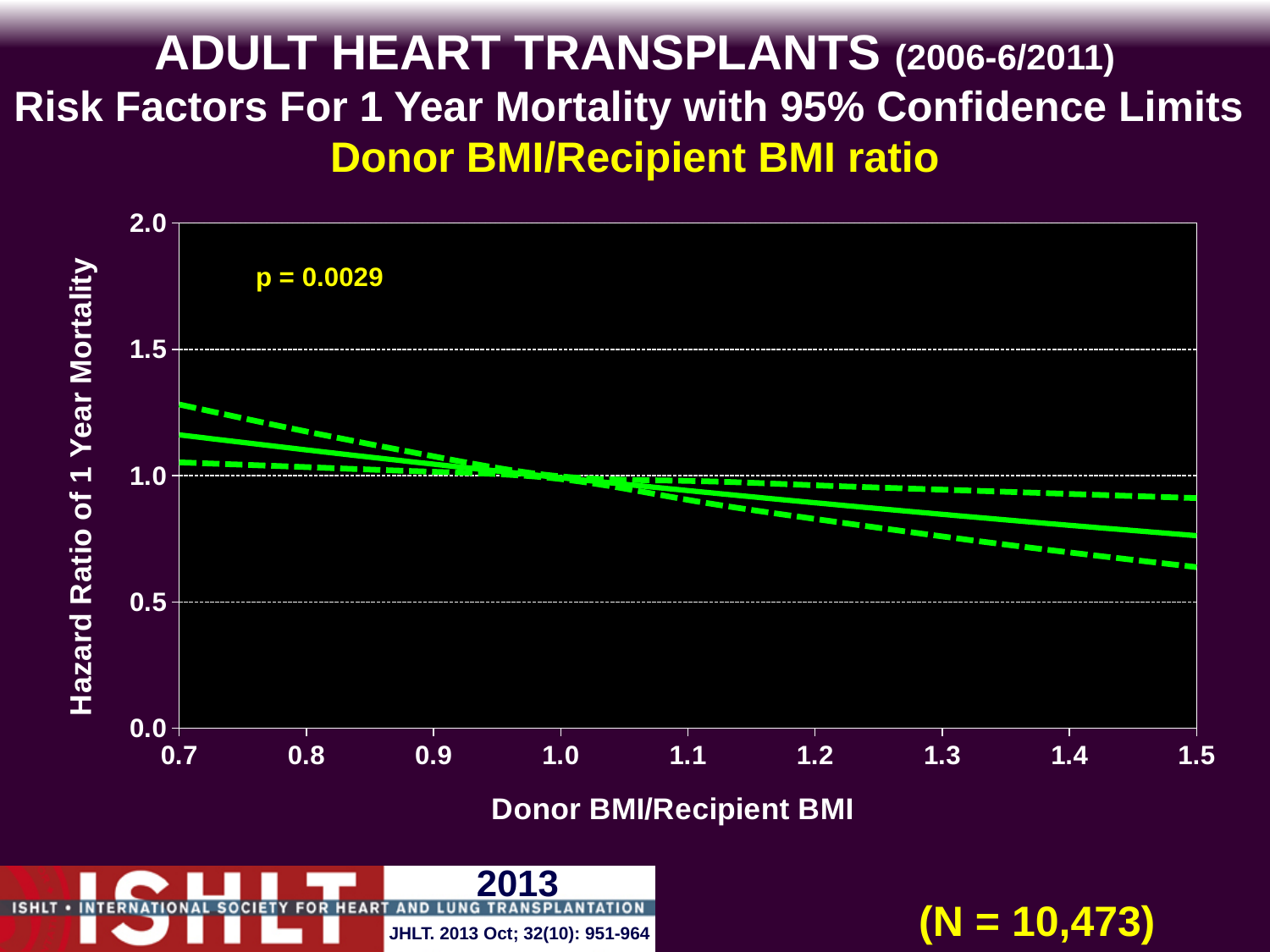
Is the hazard ratio (solid line) higher at a Donor BMI/Recipient BMI ratio of 0.7 or at 1.5? 0.7 Is the upper 95% confidence limit at a Donor BMI/Recipient BMI ratio of 0.7 greater or less than 1.5? less How many lines are plotted on the chart? 3 Is the hazard ratio (solid line) at a Donor BMI/Recipient BMI ratio of 1.5 greater or less than 1.0? less Is the lower 95% confidence limit at a Donor BMI/Recipient BMI ratio of 1.5 greater or less than 0.5? greater What is the minimum value shown on the x axis? 0.7 What is the p-value shown on the chart? p = 0.0029 What kind of chart is shown on the slide? line chart Does the hazard ratio rise or fall as the Donor BMI/Recipient BMI ratio increases from 0.7 to 1.5? fall What is the maximum value shown on the y axis? 2.0 What is the label of the y axis? Hazard Ratio of 1 Year Mortality